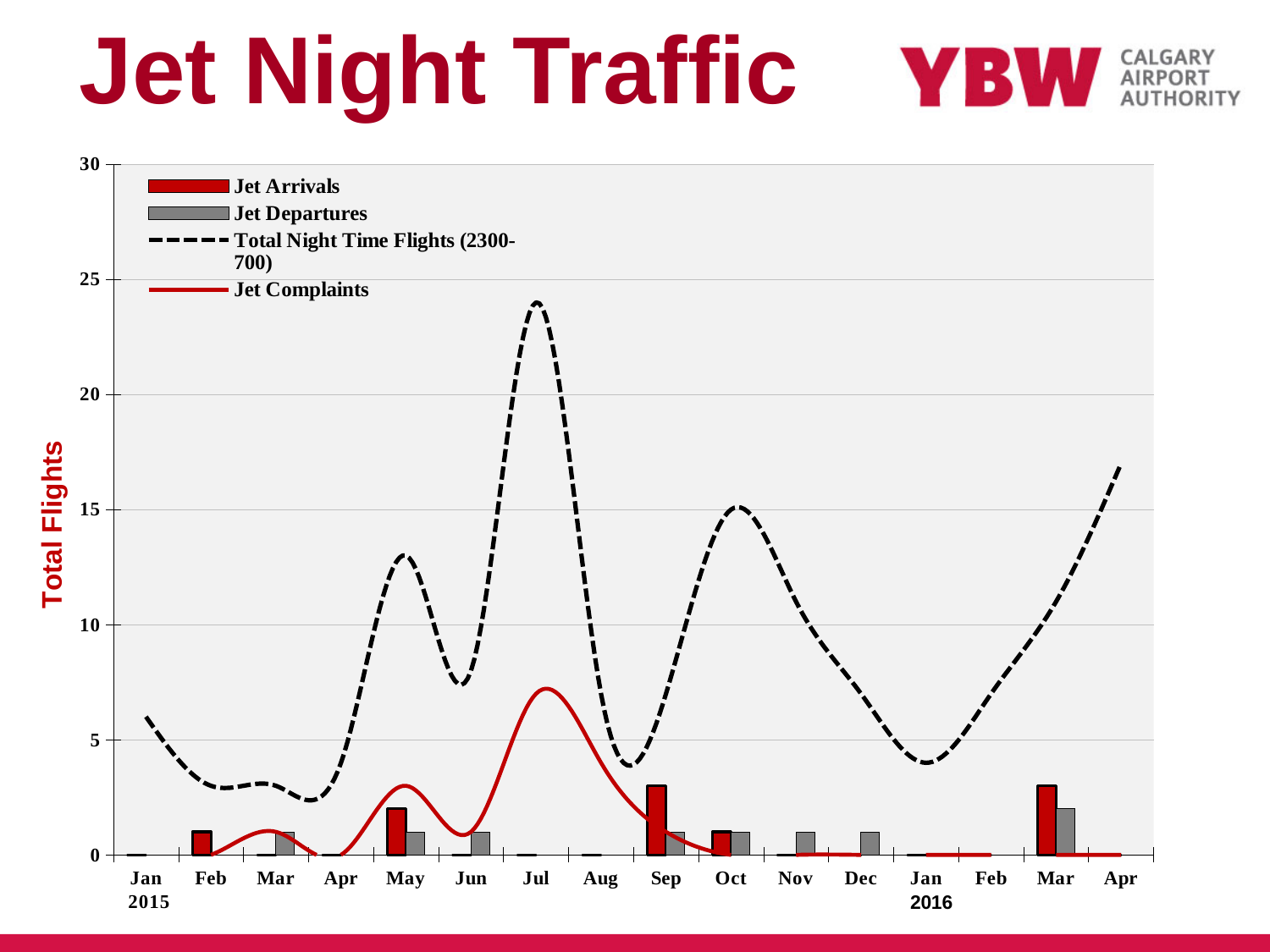
What kind of chart is shown on the slide? A combined bar and line chart Which month has the taller Jet Arrivals bar, Feb 2015 or Sep 2015? Sep 2015 In which month does the Total Night Time Flights line reach its highest value? Jul 2015 How many series does the legend list? 4 In which month does the Jet Complaints line reach its highest value? Jul 2015 What is the title of the y axis? Total Flights How many months are shown along the x axis? 16 Is the value of Total Night Time Flights in Apr 2016 greater or less than 15? greater Does the Total Night Time Flights line rise or fall from Jan 2016 to Apr 2016? rise Which series is drawn as a dashed black line? Total Night Time Flights (2300-700) Is the value of Total Night Time Flights in Dec 2015 greater or less than 10? less Is the value of Total Night Time Flights in Jul 2015 greater or less than 20? greater